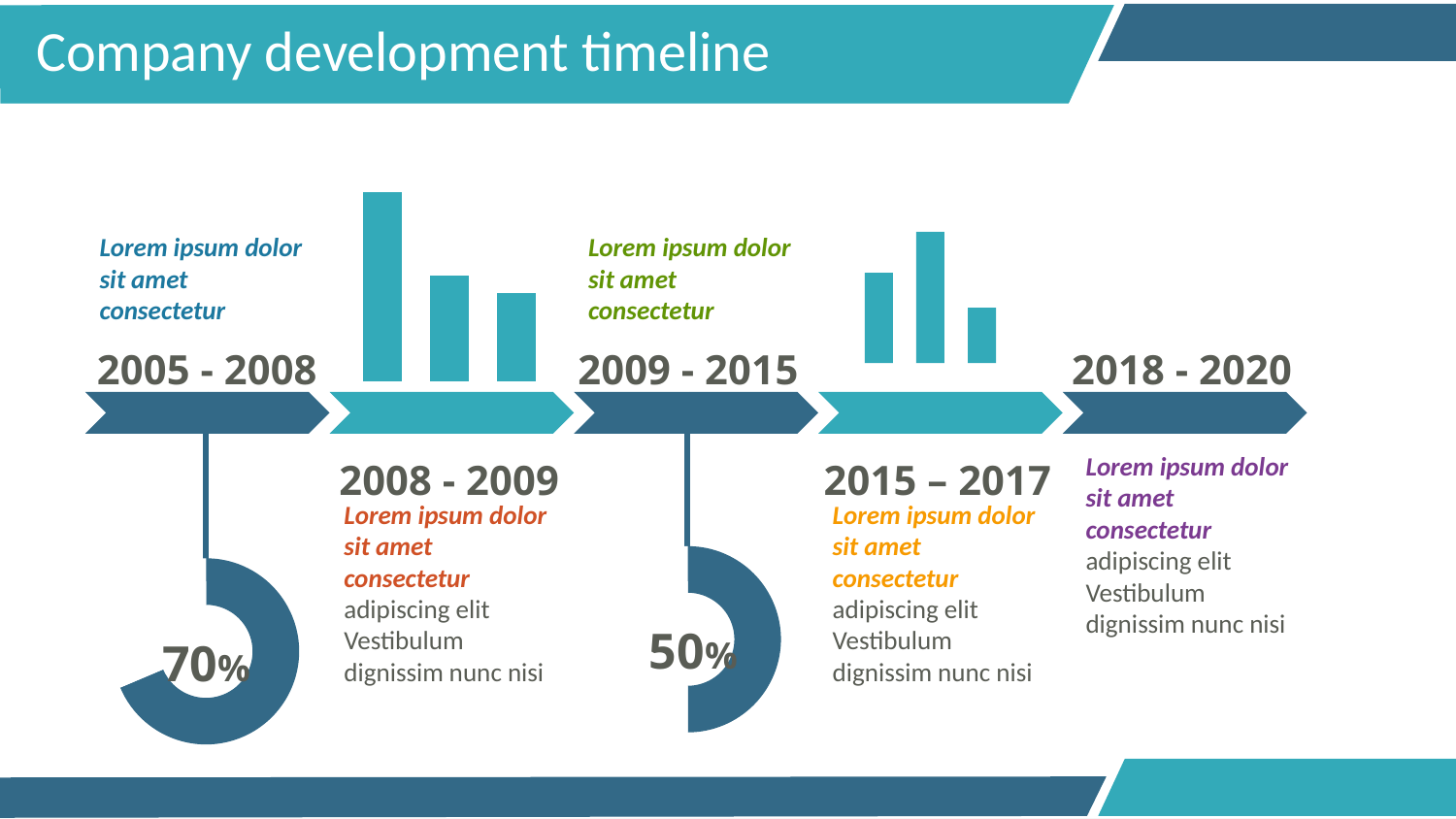
What kind of chart is shown above the 2008 - 2009 label on the left side of the timeline? bar chart What percentage is shown in the donut chart below the 2009 - 2015 label? 50% What percentage is shown in the donut chart below the 2005 - 2008 label? 70% How many bars are in the bar chart above the 2015 – 2017 label? 3 In the bar chart above the 2015 – 2017 label, which bar is the shortest? the rightmost bar In the bar chart above the 2008 - 2009 label, which bar is the tallest? the leftmost bar Which donut chart shows the larger percentage, the one below 2005 - 2008 or the one below 2009 - 2015? the one below 2005 - 2008 In the bar chart above the 2015 – 2017 label, which bar is the tallest? the middle bar What kind of chart displays the 70% value on the slide? donut chart In the bar chart above the 2008 - 2009 label, which bar is the shortest? the rightmost bar How many bars are in the bar chart above the 2008 - 2009 label? 3 What is the difference between the percentages shown in the two donut charts? 20%